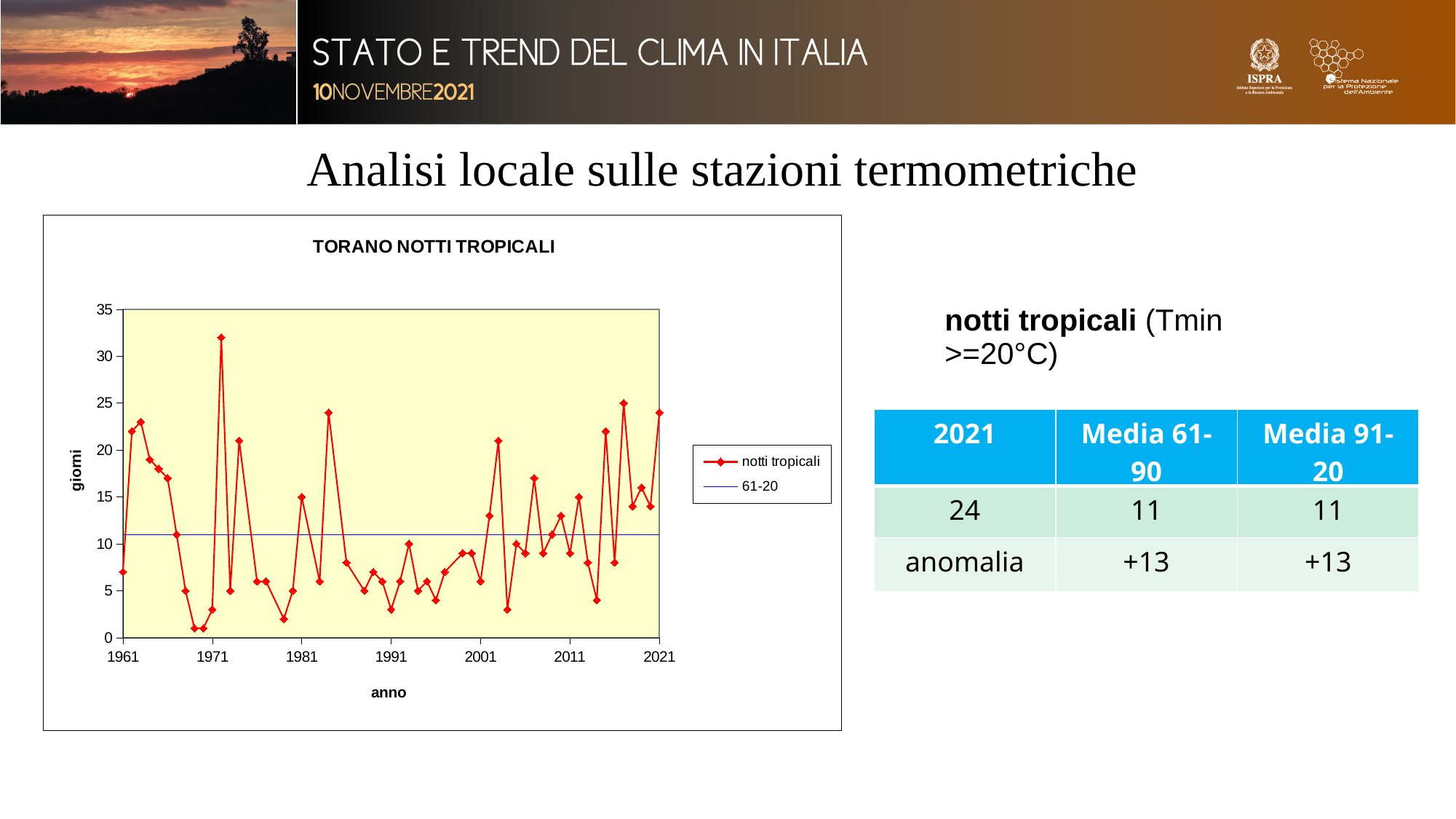
Is the value for 2001 greater or less than 10? less Is the value for 1961 greater or less than 10? less How many series does the chart legend list? 2 Is the highest value on the chart greater or less than 30? greater Which year has the larger value, 1961 or 2021? 2021 According to the table next to the chart, how many notti tropicali were recorded in 2021? 24 What kind of chart is shown on the slide? line chart What is the title of the chart? TORANO NOTTI TROPICALI What are the two entries in the chart legend? notti tropicali and 61-20